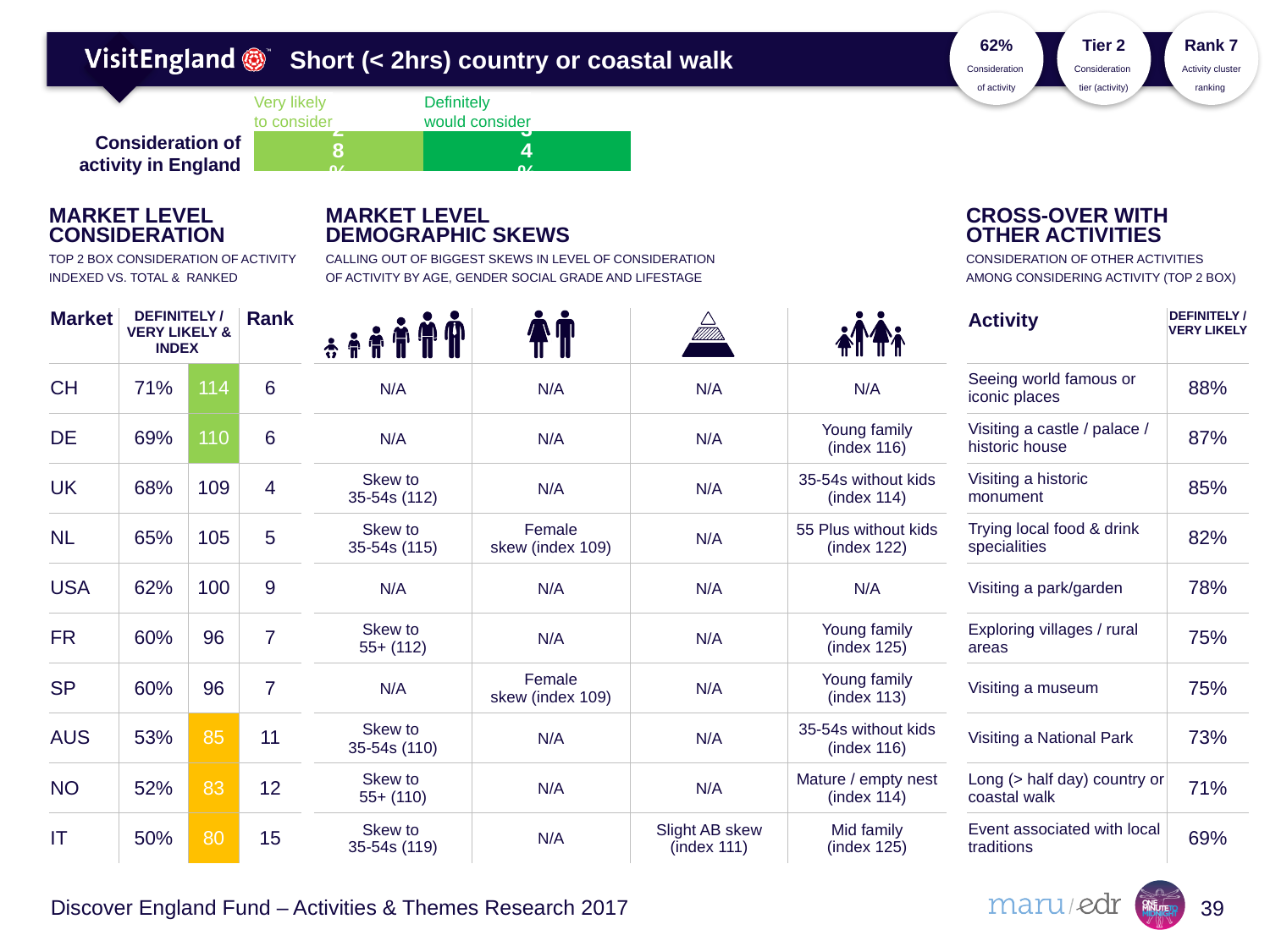
In the 'Consideration of activity in England' chart, what is the total of the stacked bar? 62% In the 'Consideration of activity in England' chart, which series is shown in the darker green colour? Definitely would consider How many bars does the 'Consideration of activity in England' chart contain? 1 What are the two series names in the 'Consideration of activity in England' chart? Very likely to consider; Definitely would consider In the 'Consideration of activity in England' chart, which segment is larger: 'Very likely to consider' or 'Definitely would consider'? Definitely would consider In the 'Consideration of activity in England' chart, what is the value for 'Definitely would consider'? 34% What kind of chart is the 'Consideration of activity in England' chart? bar chart How many series does the 'Consideration of activity in England' chart show? 2 In the 'Consideration of activity in England' chart, what is the difference between 'Definitely would consider' and 'Very likely to consider'? 6% In the 'Consideration of activity in England' chart, what is the value for 'Very likely to consider'? 28%